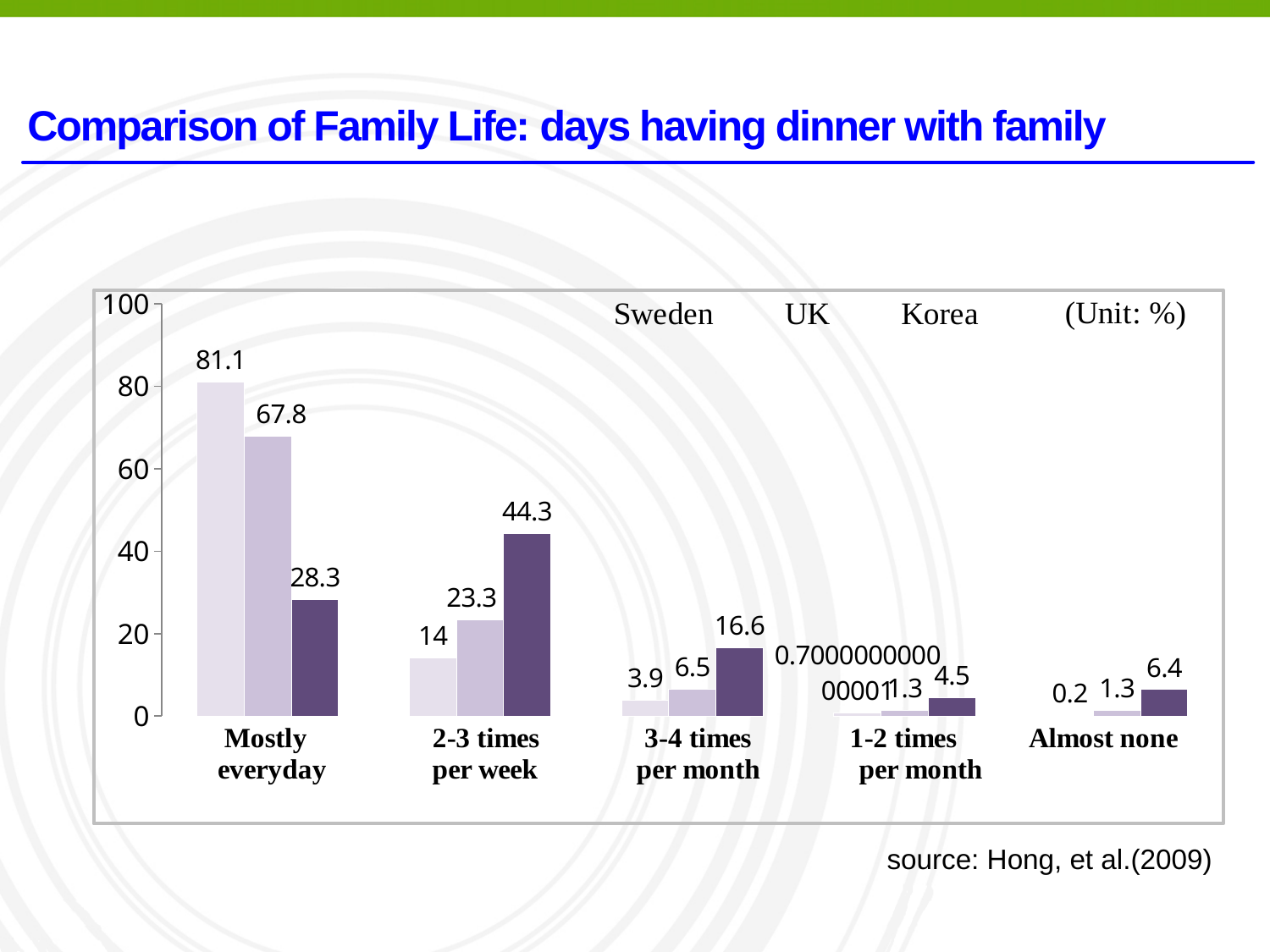
Which country has the lowest value in the 'Almost none' category? Sweden What is the difference between the Sweden and UK values in the 'Mostly everyday' category? 13.3 In the '2-3 times per week' category, which is larger: the value for Sweden or the value for UK? UK How many series does the legend list? 3 Which country has the highest value in the 'Mostly everyday' category? Sweden How many categories are shown on the x axis? 5 What is the value for Sweden in the 'Mostly everyday' category? 81.1 What type of chart is shown on the slide? bar chart What unit is indicated for the values in the chart? % What is the value for Korea in the 'Almost none' category? 6.4 What is the value for Korea in the '2-3 times per week' category? 44.3 What is the value for UK in the '3-4 times per month' category? 6.5